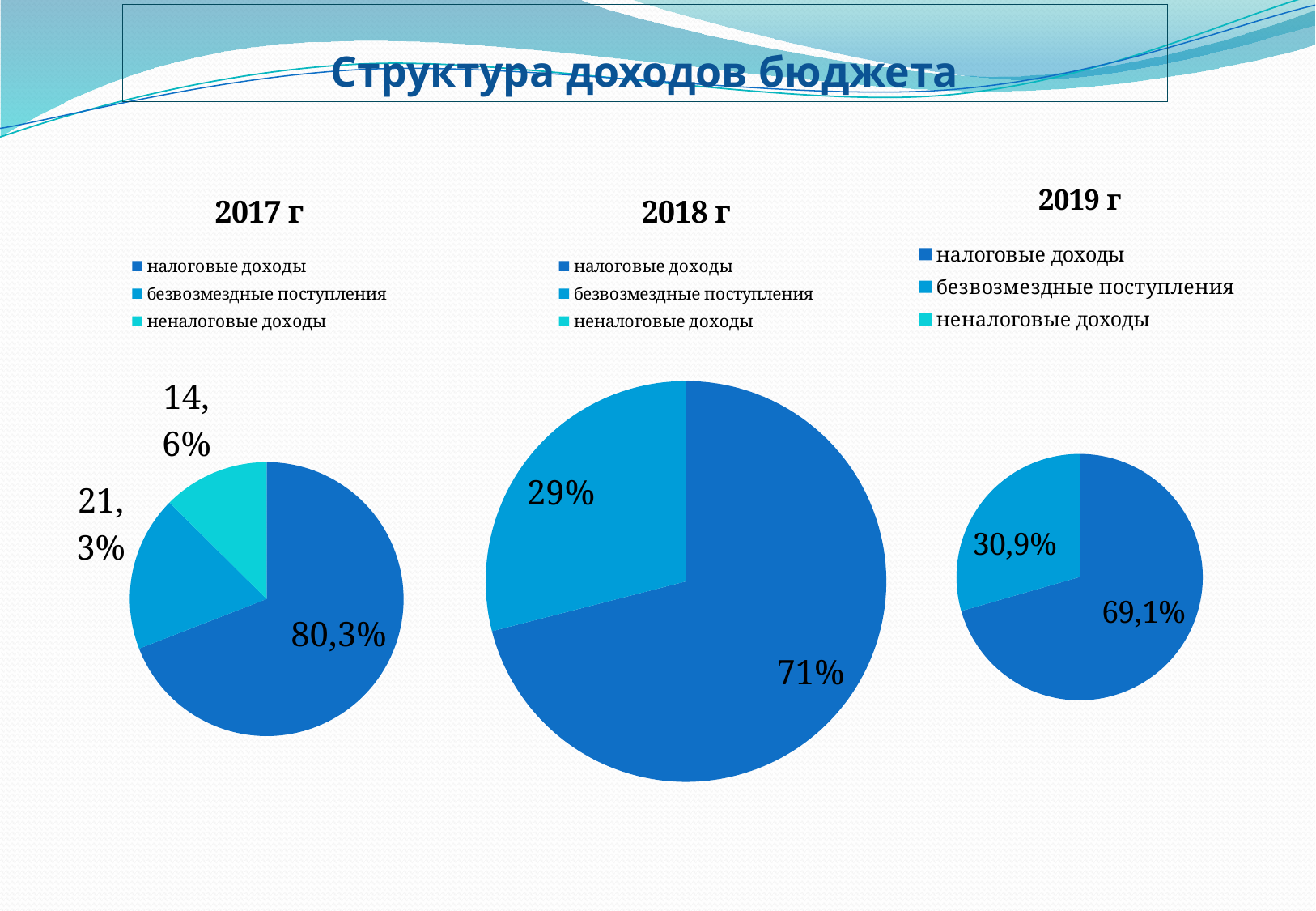
Is the share of налоговые доходы larger in the 2017 г chart or in the 2019 г chart? 2017 г In the 2019 г chart, which category has the largest slice? налоговые доходы What is the difference between the налоговые доходы share in the 2017 г chart (80,3%) and in the 2019 г chart (69,1%)? 11,2% How many entries does the legend of the 2019 г chart list? 3 In the 2018 г chart, what share is shown for налоговые доходы? 71% In the 2017 г chart, what share is shown for безвозмездные поступления? 21,3% In the 2017 г chart, what share is shown for неналоговые доходы? 14,6% In the 2018 г chart, what share is shown for безвозмездные поступления? 29% In the 2017 г chart, what share is shown for налоговые доходы? 80,3% In the 2017 г chart, which category has the smallest slice? неналоговые доходы In the 2019 г chart, what share is shown for безвозмездные поступления? 30,9% What kind of chart is used for 2018 г? pie chart